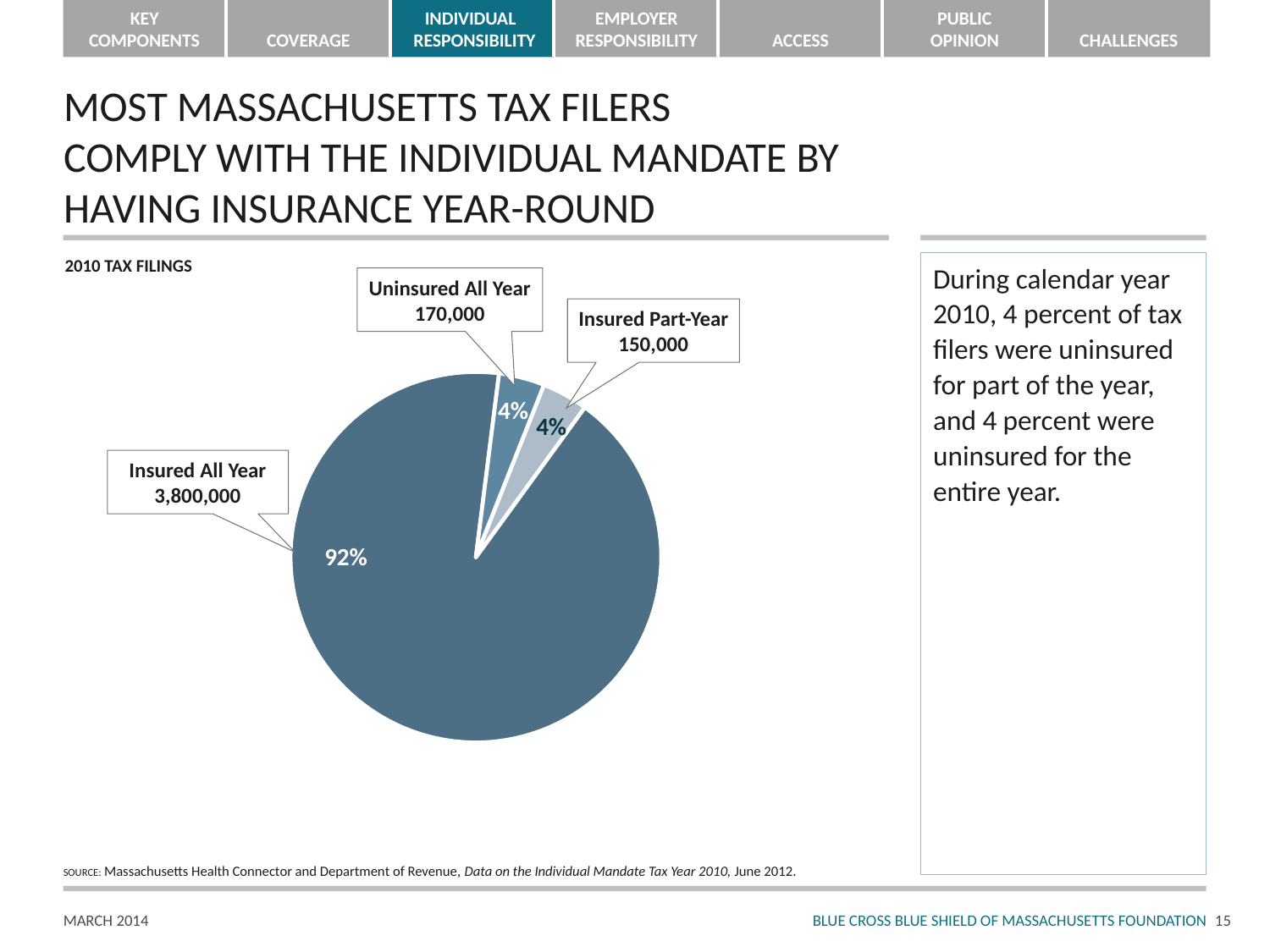
How many slices does the pie chart have? 3 What is the difference between the values for Uninsured All Year and Insured Part-Year? 20,000 Which category has the smallest value in the pie chart? Insured Part-Year What is the label above the pie chart? 2010 TAX FILINGS What share of the pie does Uninsured All Year represent? 4% What is the value for Insured Part-Year? 150,000 What is the value for Insured All Year? 3,800,000 Which is larger, the value for Uninsured All Year or the value for Insured Part-Year? Uninsured All Year What share of the pie does Insured All Year represent? 92% What type of chart is shown on the slide? Pie chart What is the value for Uninsured All Year? 170,000 Which category has the largest slice of the pie? Insured All Year